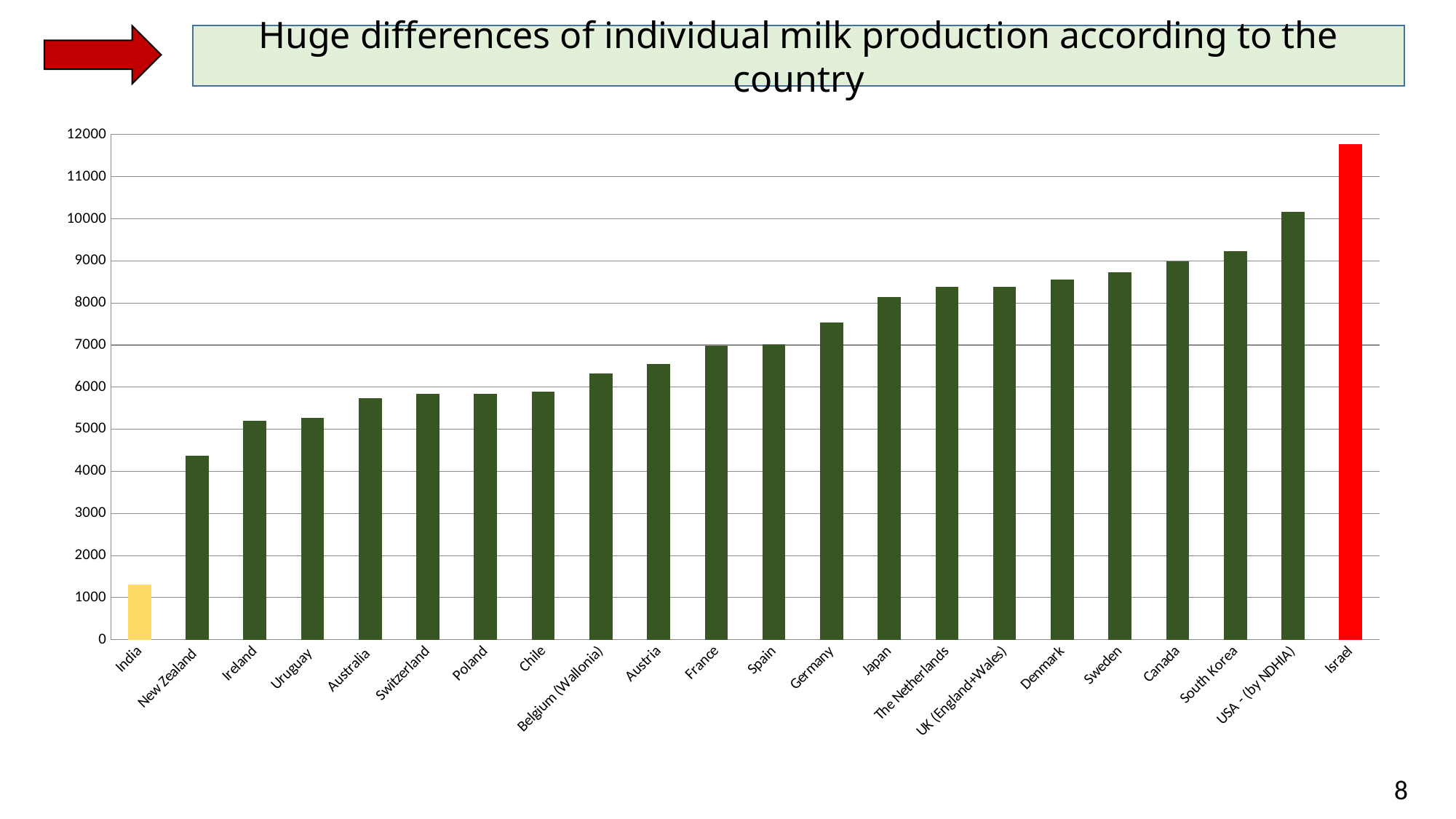
Is the value for Germany greater or less than 7000? greater Is the value for Israel greater or less than 11000? greater Is the value for India greater or less than 2000? less How many countries are shown on the x axis of the chart? 22 Do the bar values generally rise or fall from left to right along the x axis? Rise Which country has the highest bar in the chart? Israel What kind of chart is shown on the slide? Bar chart Which country has the lowest bar in the chart? India Which has the larger value, Israel or USA - (by NDHIA)? Israel What colour is the bar for Israel? Red